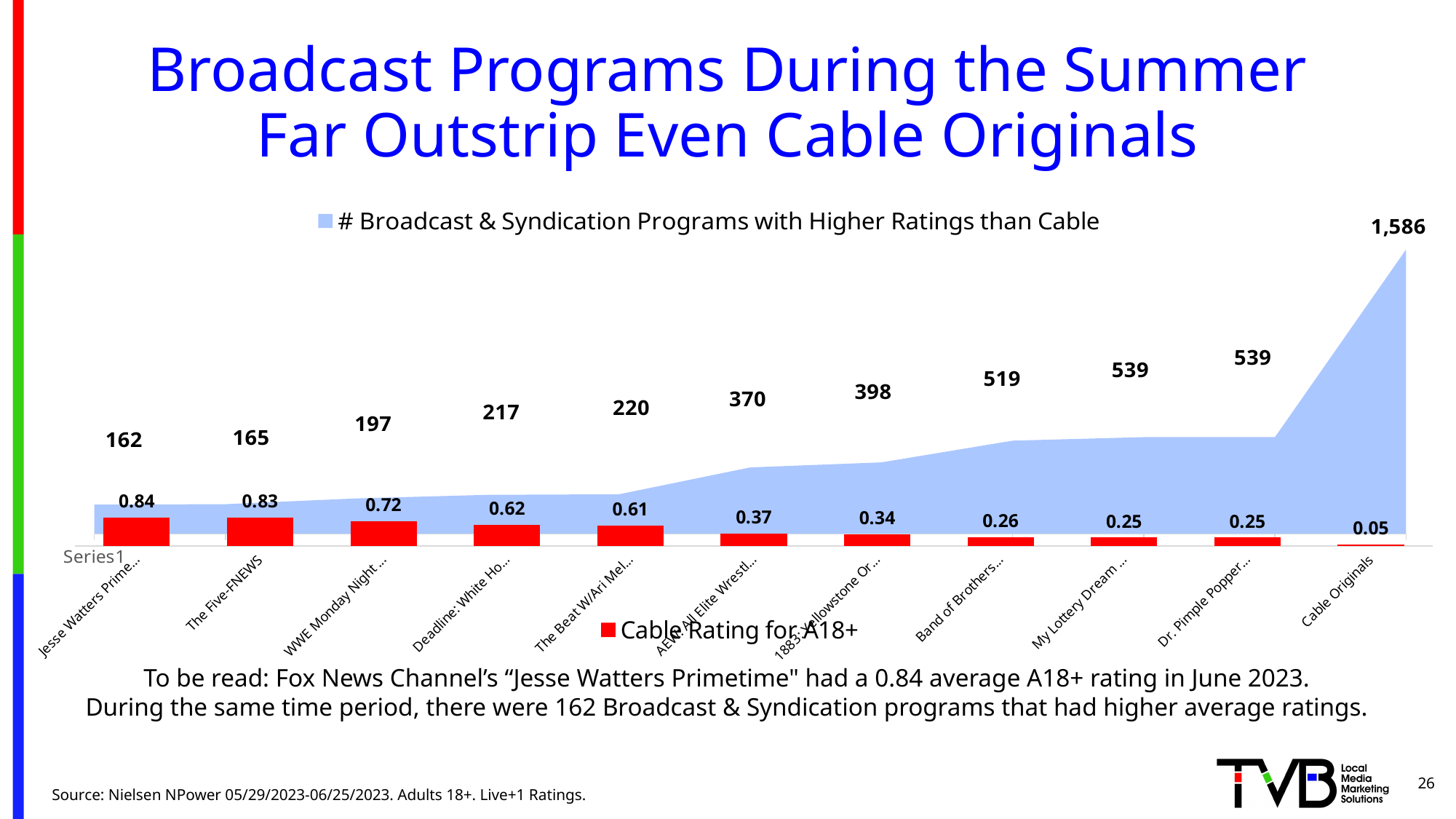
How many data series does the chart show? 2 What kind of chart is shown on the slide? A combination area and bar chart Does the number of Broadcast & Syndication programs with higher ratings than cable rise or fall from left to right across the x axis? Rise How many categories are shown along the x axis of the chart? 11 Which has more Broadcast & Syndication programs with higher ratings than cable: Band of Brothers or The Five-FNEWS? Band of Brothers What is the difference between the number of Broadcast & Syndication programs with higher ratings for Cable Originals and for Dr. Pimple Popper? 1,047 Which category has the highest number of Broadcast & Syndication programs with higher ratings than cable? Cable Originals Which category has the lowest Cable Rating for A18+? Cable Originals What is the Cable Rating for A18+ for Band of Brothers? 0.26 What is the Cable Rating for A18+ for The Five-FNEWS? 0.83 How many Broadcast & Syndication programs had higher ratings than Cable Originals? 1,586 What is the difference between the Cable Rating for A18+ for Jesse Watters Primetime and The Five-FNEWS? 0.01